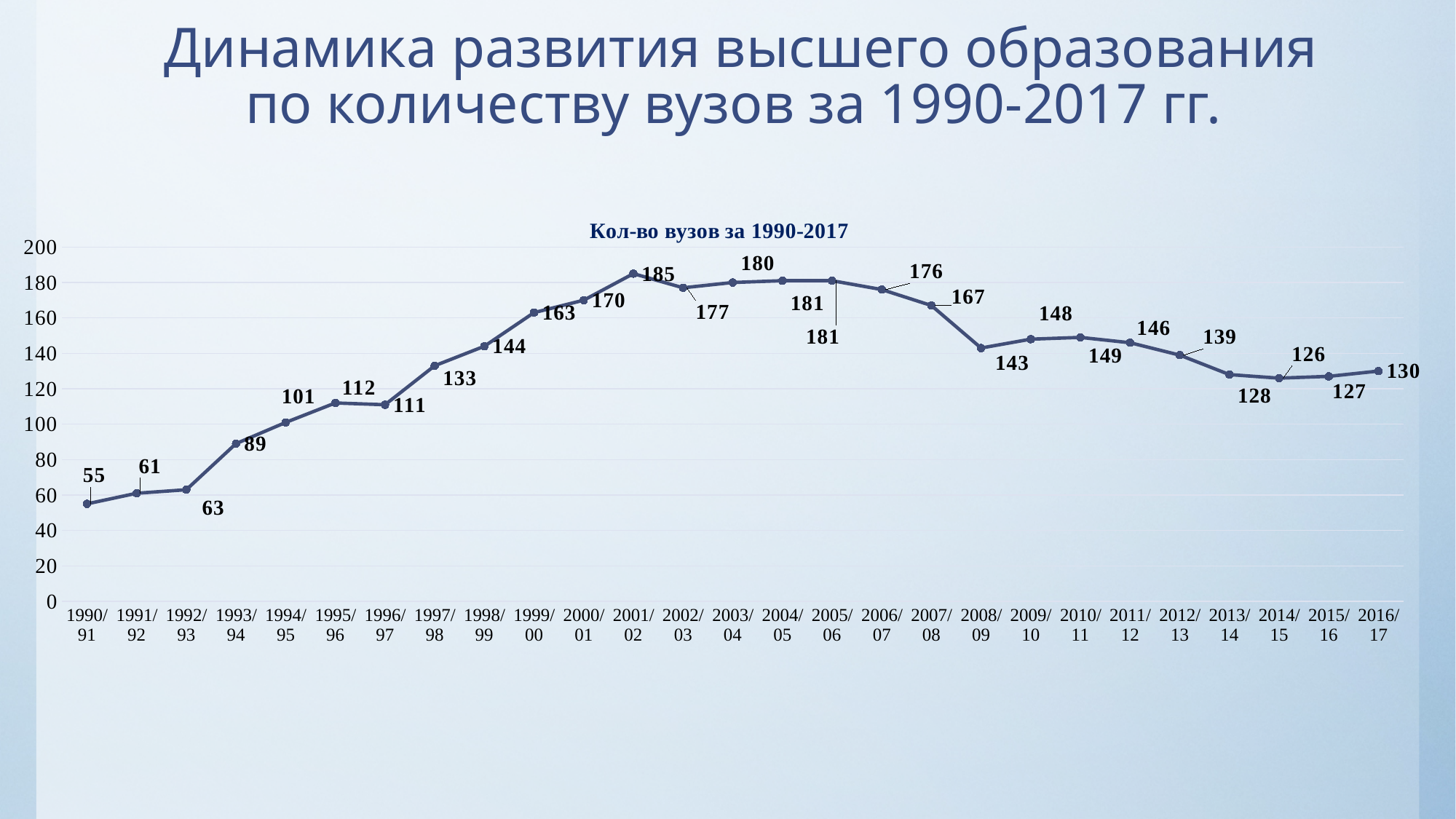
What is the difference between the values for 2001/02 and 2016/17? 55 What is the value for 1990/91? 55 Which year has the lowest value? 1990/91 What is the value for 2001/02? 185 Do the values rise or fall from 1990/91 to 2001/02? rise What is the title of the chart? Кол-во вузов за 1990-2017 Which year has the highest value? 2001/02 Which is larger, the value for 2007/08 or the value for 2008/09? 2007/08 What is the value for 2016/17? 130 What type of chart is shown on the slide? line chart What is the difference between the values for 1993/94 and 1992/93? 26 How many data points are plotted on the chart? 27